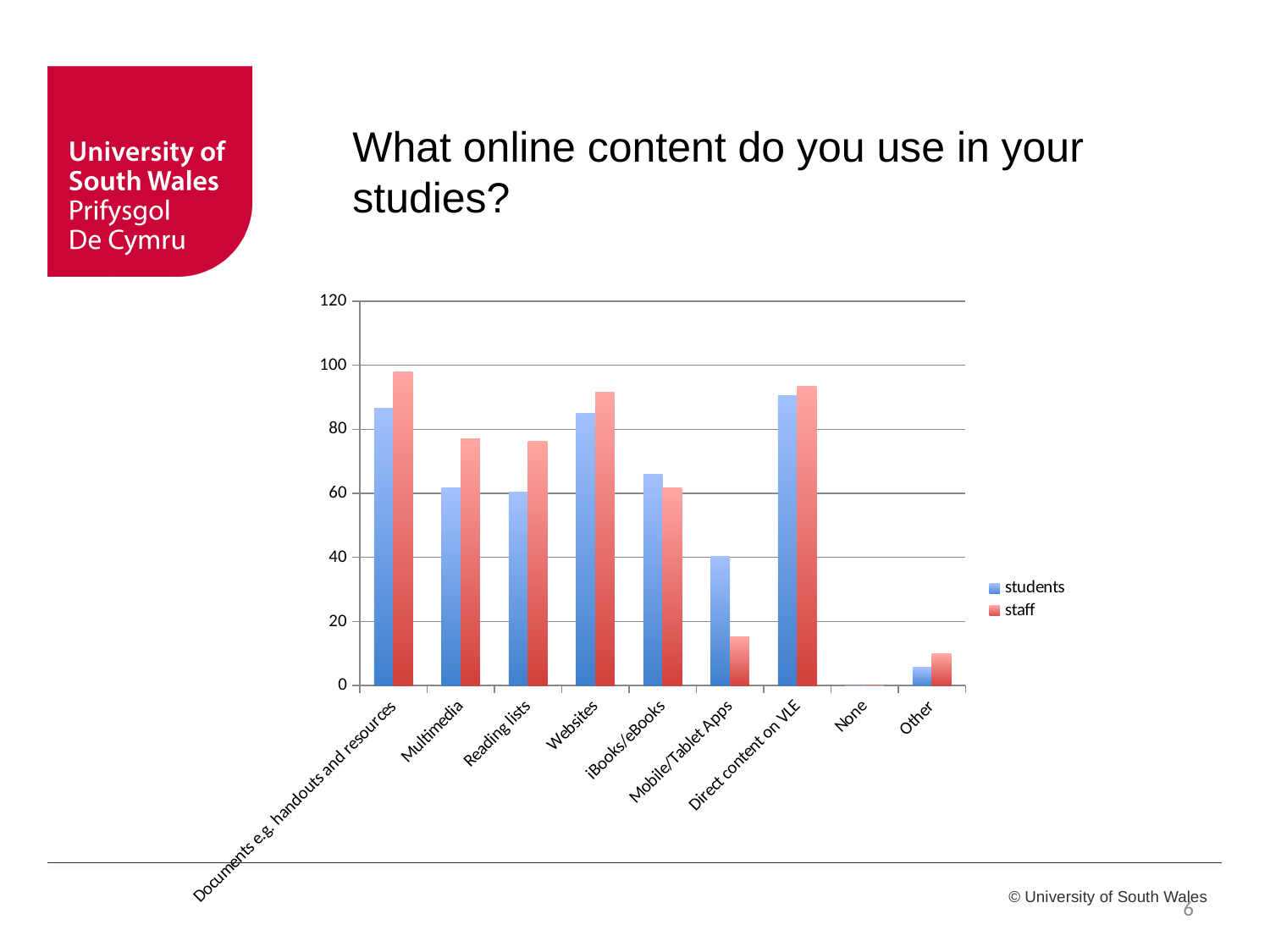
What kind of chart is shown on the slide? bar chart Is the staff value for Documents e.g. handouts and resources greater or less than 80? greater Is the students value for Mobile/Tablet Apps greater or less than 20? greater How many categories are shown on the x axis? 9 Which category has the highest value for staff? Documents e.g. handouts and resources For Multimedia, which is larger: the students value or the staff value? staff Is the staff value for Mobile/Tablet Apps greater or less than 20? less What colour are the bars for the staff series? red How many series does the legend list? 2 For Mobile/Tablet Apps, which is larger: the students value or the staff value? students Which category has the lowest value for both students and staff? None